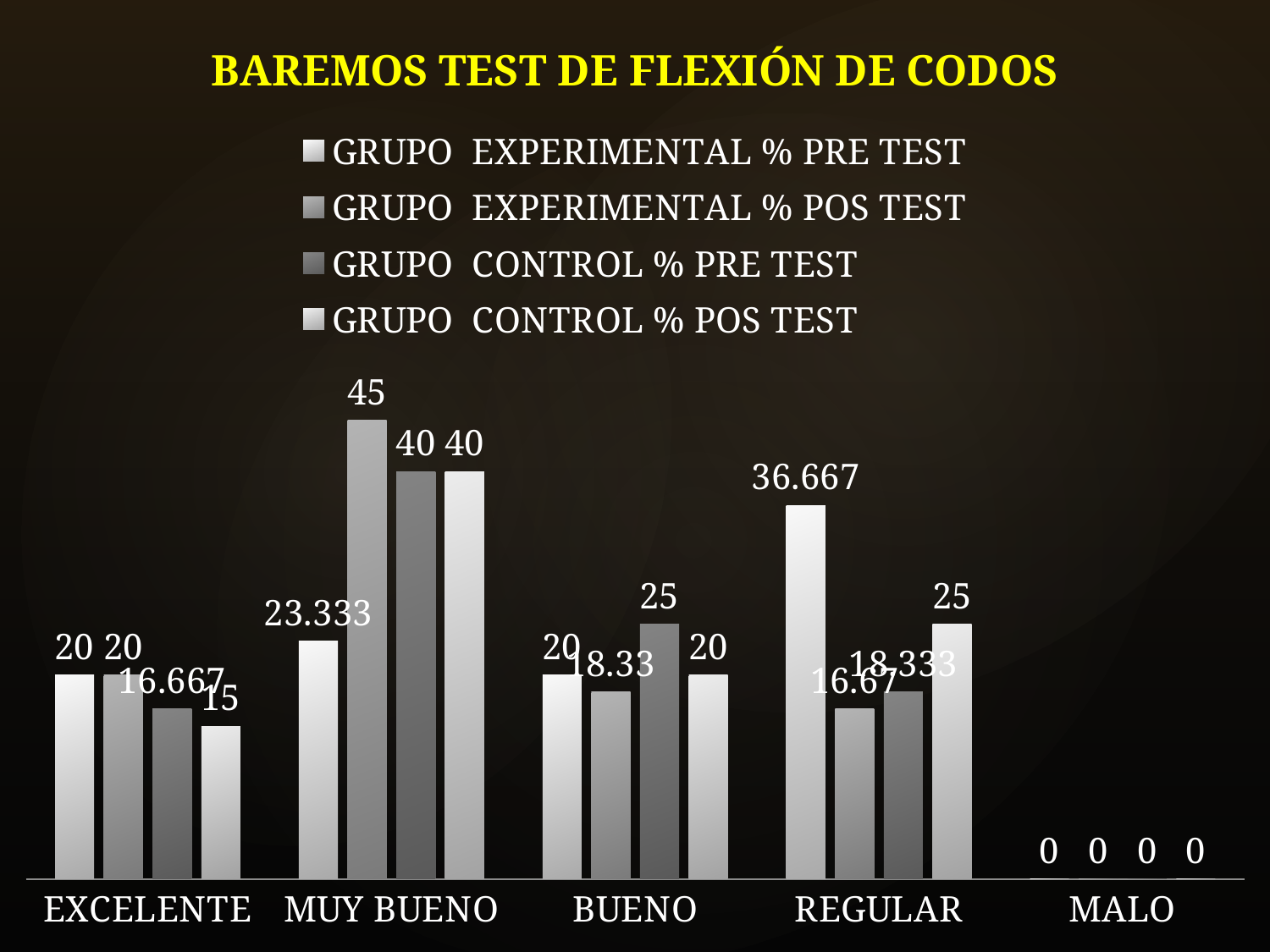
What is the difference between GRUPO EXPERIMENTAL % POS TEST and GRUPO EXPERIMENTAL % PRE TEST in the MUY BUENO category? 21.667 Which category has the lowest values for all four series? MALO How many series does the legend list? 4 What is the title of the chart? BAREMOS TEST DE FLEXIÓN DE CODOS What is the value for GRUPO EXPERIMENTAL % PRE TEST in the REGULAR category? 36.667 What is the value for GRUPO EXPERIMENTAL % POS TEST in the MUY BUENO category? 45 What is the value for GRUPO CONTROL % POS TEST in the EXCELENTE category? 15 In the REGULAR category, which is larger: GRUPO EXPERIMENTAL % PRE TEST or GRUPO CONTROL % POS TEST? GRUPO EXPERIMENTAL % PRE TEST How many categories are shown on the x axis? 5 What is the value for GRUPO CONTROL % PRE TEST in the BUENO category? 25 Which category has the highest value for GRUPO EXPERIMENTAL % POS TEST? MUY BUENO What kind of chart is shown on the slide? bar chart